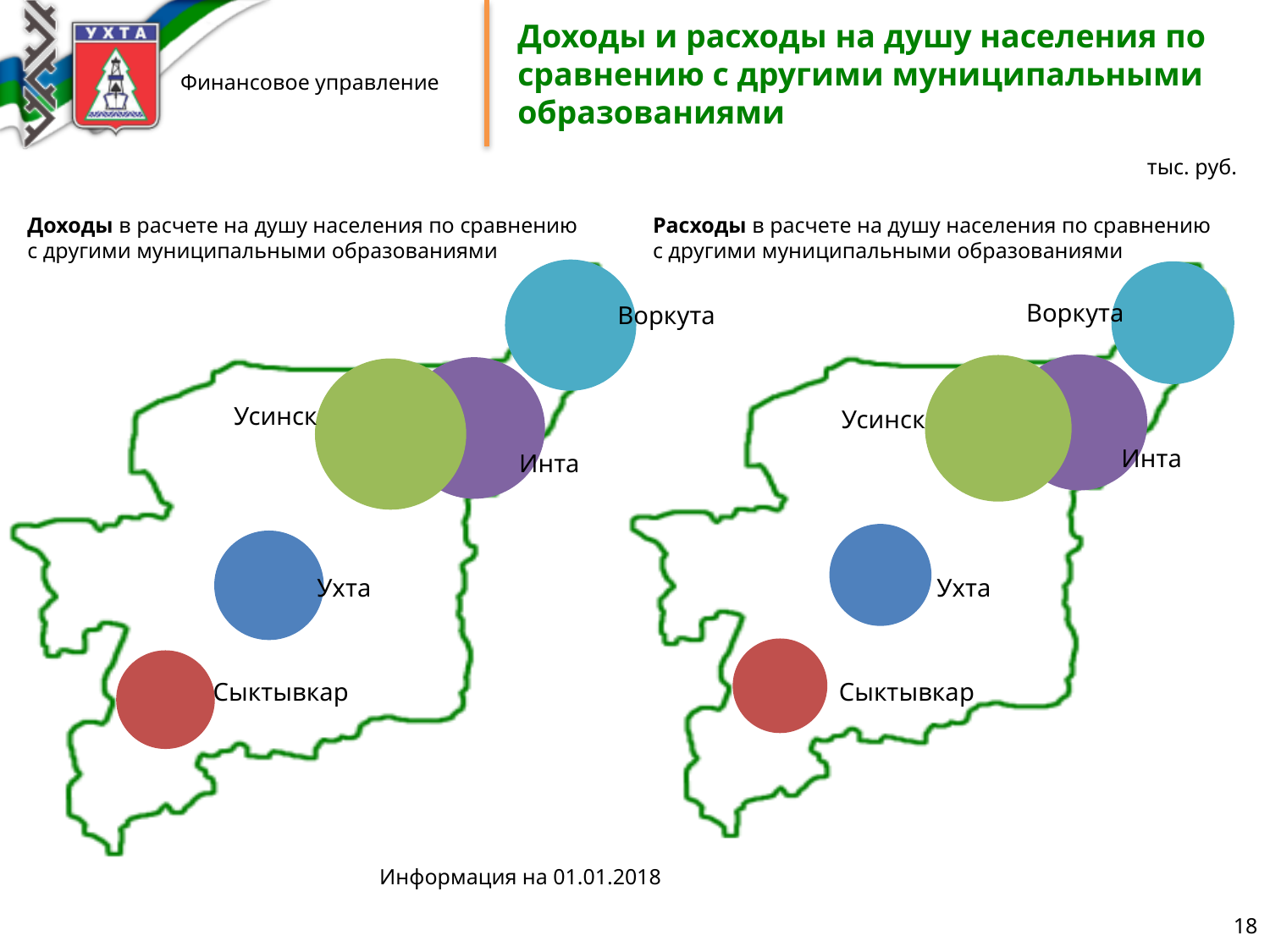
What kind of chart is used on the slide to show per-capita incomes and expenditures? Bubble chart In the right chart (Расходы), which bubble is larger, Воркута or Ухта? Воркута What colour is the bubble for Ухта in both charts? Blue In the left chart (Доходы), which municipality has the largest bubble? Усинск In the right chart (Расходы), which municipality has the smallest bubble? Сыктывкар How many charts are shown on the slide? 2 What unit of measurement is stated on the slide for the charts? тыс. руб. In the left chart (Доходы), which bubble is larger, Усинск or Сыктывкар? Усинск In the left chart (Доходы в расчете на душу населения), how many municipalities are shown as bubbles? 5 In the right chart (Расходы в расчете на душу населения), how many municipalities are shown as bubbles? 5 In the right chart (Расходы), which municipality has the largest bubble? Усинск